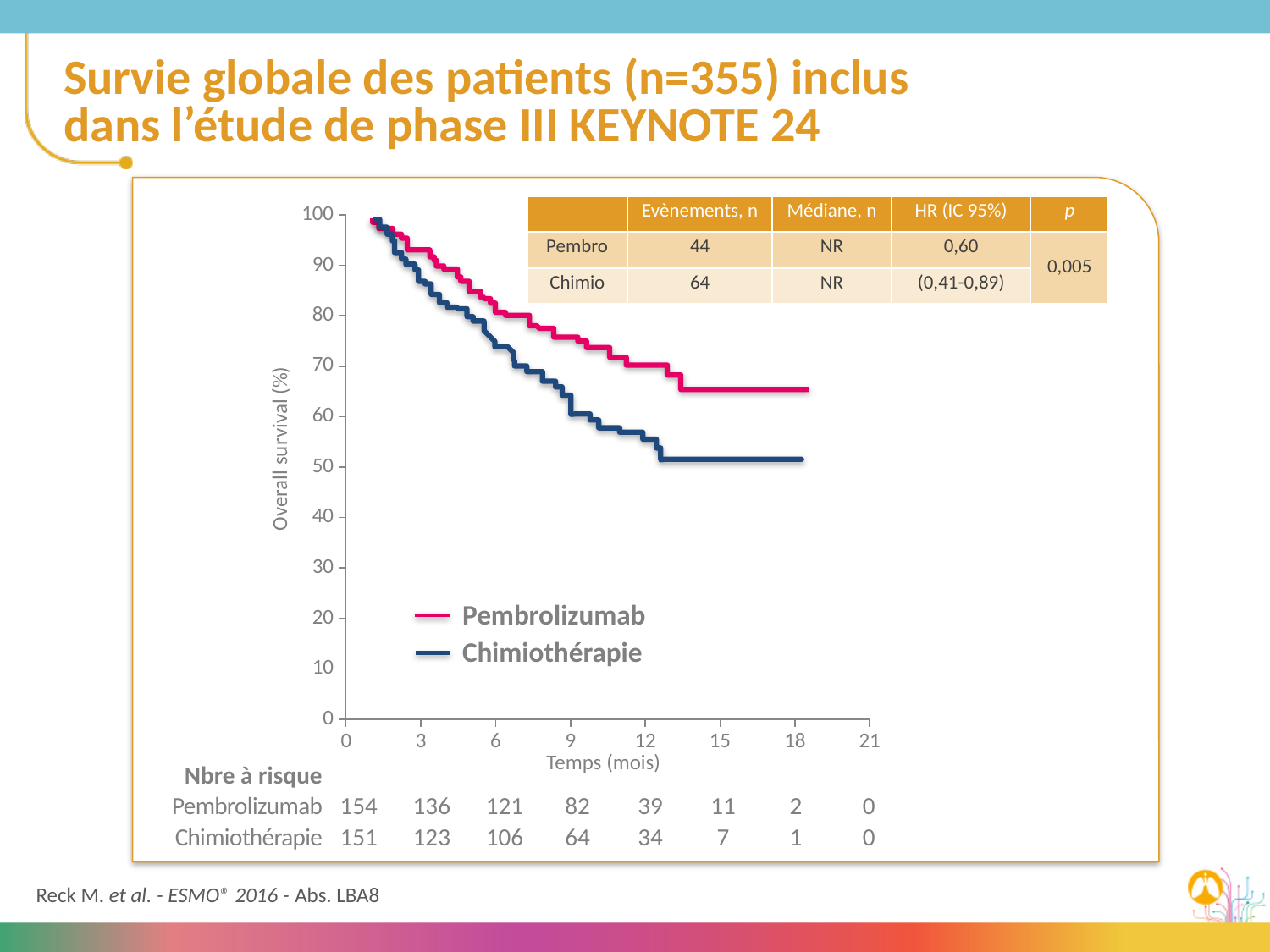
How many series does the legend list? 2 Is the overall survival for Pembrolizumab at 12 months greater or less than 60%? greater What kind of chart is shown on the slide? Line chart (Kaplan-Meier survival curve) At 12 months, which curve is higher, Pembrolizumab or Chimiothérapie? Pembrolizumab According to the 'Nbre à risque' table, how many Pembrolizumab patients were at risk at 9 months? 82 Which two series are listed in the legend? Pembrolizumab and Chimiothérapie According to the 'Nbre à risque' table, how many Chimiothérapie patients were at risk at 6 months? 106 What is the label of the y axis? Overall survival (%) Do the survival curves rise or fall as time (Temps, mois) increases? Fall What is the difference between the number of Pembrolizumab patients (154) and Chimiothérapie patients (151) at risk at 0 months? 3 In the summary table, how many events (Evènements, n) were reported for Chimio? 64 Is the overall survival for Chimiothérapie at 15 months greater or less than 60%? less